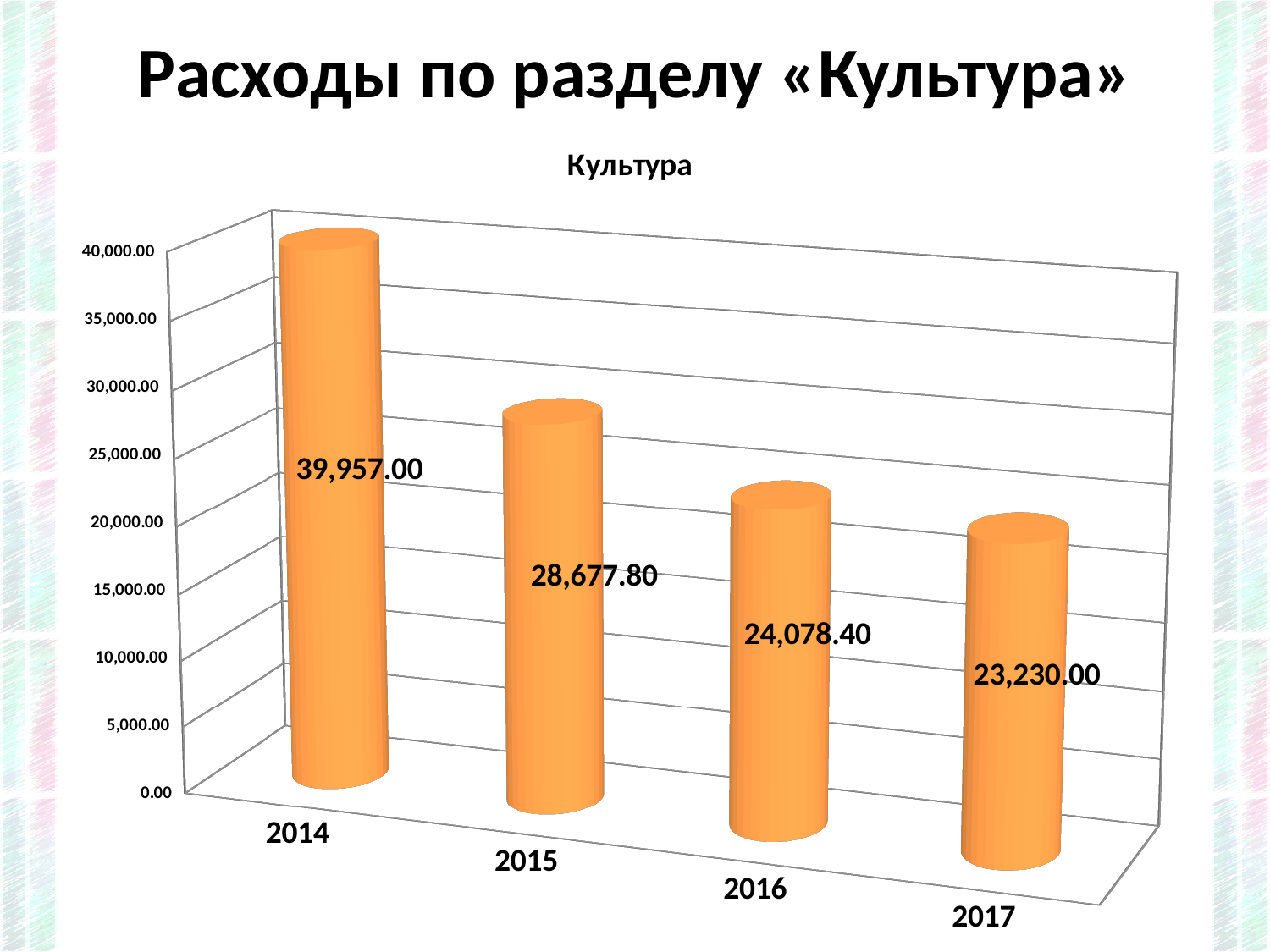
What is the value for 2016? 24,078.40 Which year has the highest value? 2014 What is the value for 2014? 39,957.00 What is the value for 2015? 28,677.80 What is the difference between the values for 2016 and 2017? 848.40 What is the difference between the values for 2014 and 2015? 11,279.20 What kind of chart is this? bar chart Do the values rise or fall from 2014 to 2017? fall Which is larger, the value for 2015 or the value for 2016? 2015 Which year has the lowest value? 2017 How many years are shown on the chart? 4 What is the value for 2017? 23,230.00